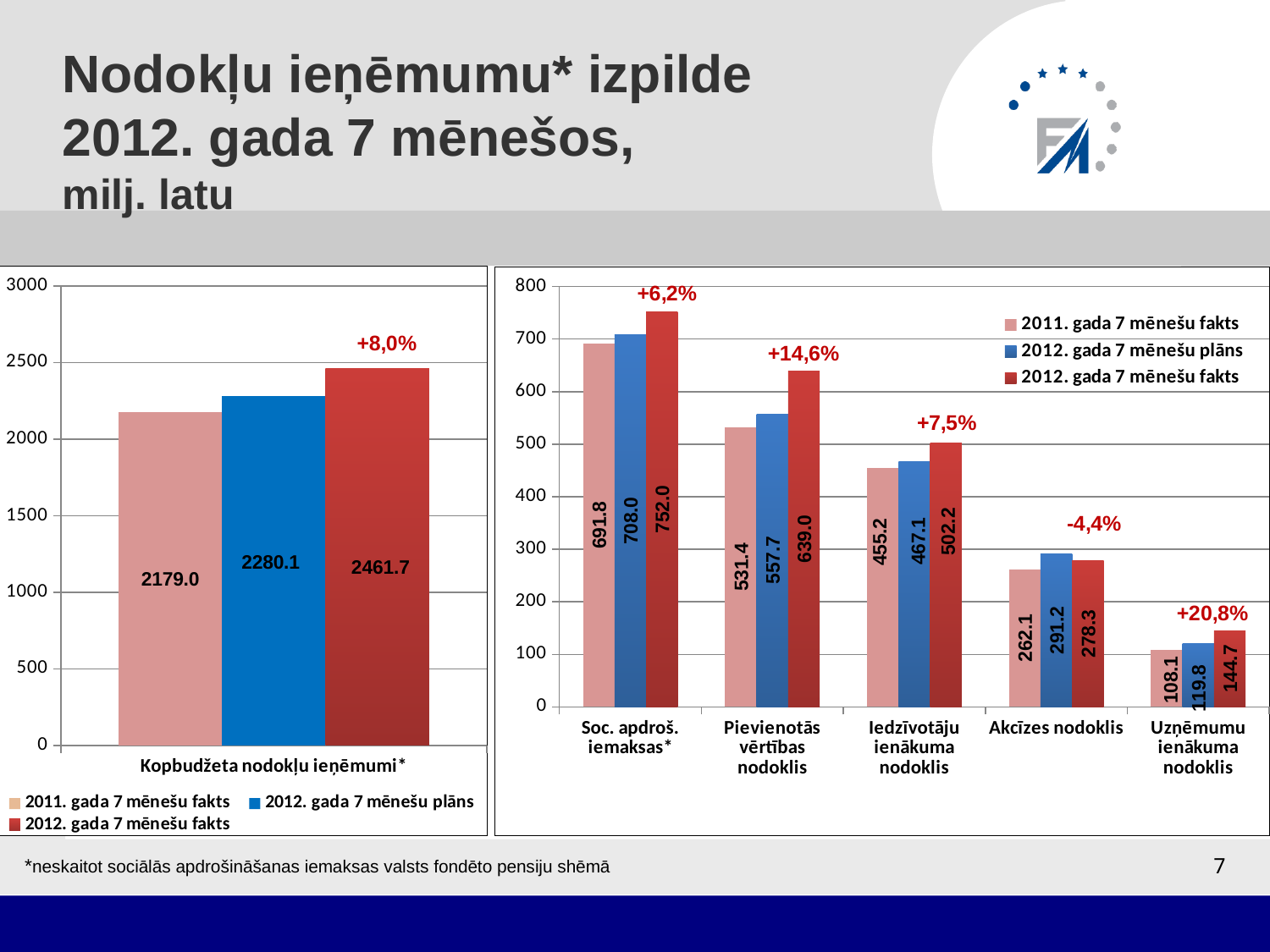
On the right chart, which category has the lowest 2011. gada 7 mēnešu fakts value? Uzņēmumu ienākuma nodoklis On the left chart, what percentage change is printed above the bars? +8,0% On the right chart, what is the 2012. gada 7 mēnešu plāns value for Akcīzes nodoklis? 291.2 On the right chart, for Akcīzes nodoklis, which is larger: the 2012. gada 7 mēnešu plāns or the 2012. gada 7 mēnešu fakts? 2012. gada 7 mēnešu plāns On the left chart, what is the value for 2011. gada 7 mēnešu fakts? 2179.0 On the right chart, what is the 2012. gada 7 mēnešu fakts value for Pievienotās vērtības nodoklis? 639.0 On the right chart, which category has the highest 2012. gada 7 mēnešu fakts value? Soc. apdroš. iemaksas* On the right chart, what is the difference between the 2012. gada 7 mēnešu fakts and 2012. gada 7 mēnešu plāns values for Pievienotās vērtības nodoklis? 81.3 How many categories are shown on the x axis of the right chart? 5 How many series does the legend of the right chart list? 3 On the left chart, what is the value for 2012. gada 7 mēnešu fakts for Kopbudžeta nodokļu ieņēmumi? 2461.7 On the left chart, what is the difference between the 2012. gada 7 mēnešu fakts and the 2011. gada 7 mēnešu fakts values? 282.7